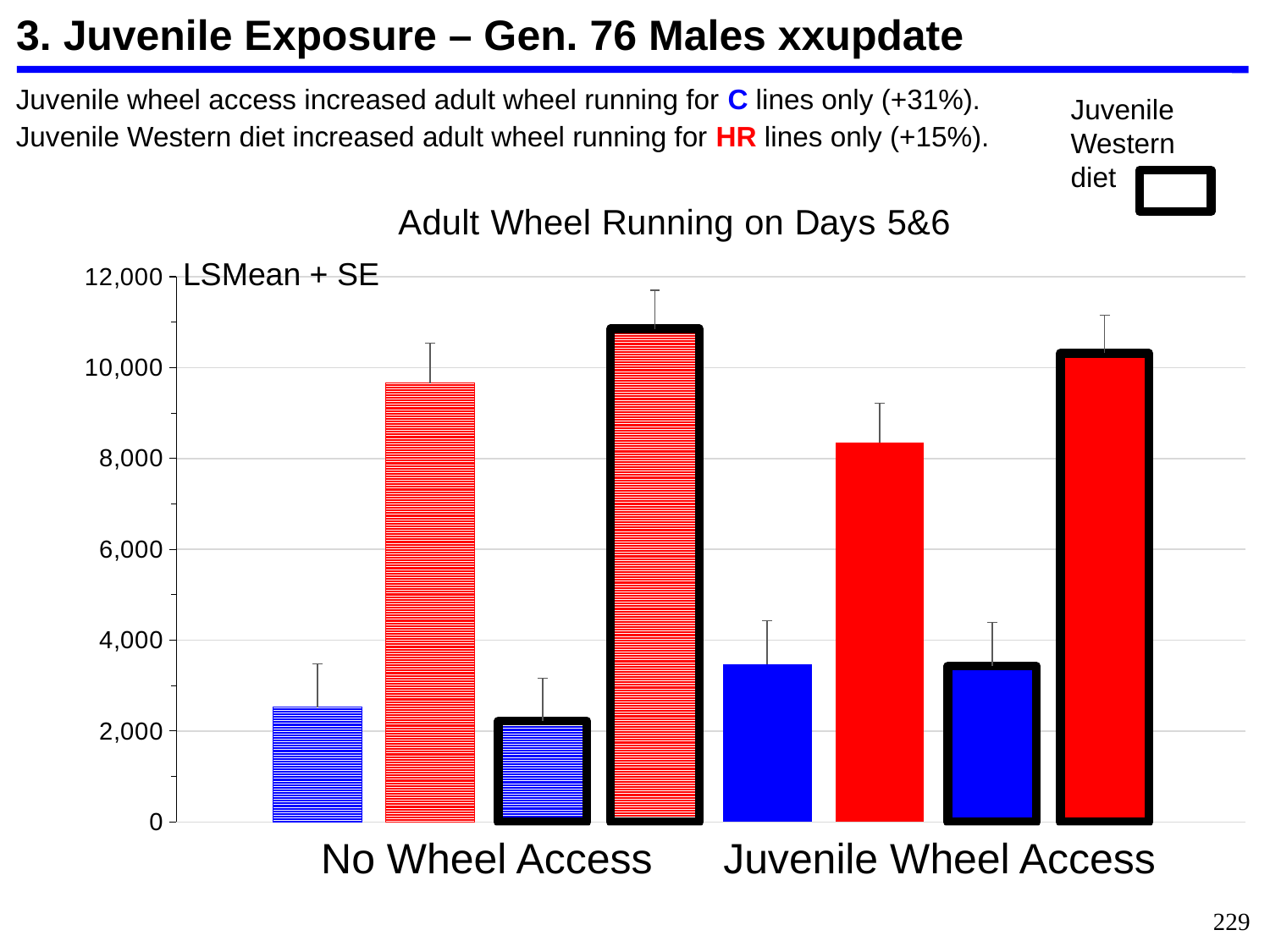
How many bars are plotted in the No Wheel Access group? 4 What is the title of the chart? Adult Wheel Running on Days 5&6 Is the value of the solid red bar in the No Wheel Access group greater or less than 8,000? greater Is the value of the blue bar with the black outline in the Juvenile Wheel Access group greater or less than 2,000? greater Which bar is the tallest in the chart? the red bar with black outline in the No Wheel Access group Is the value of the solid blue bar in the No Wheel Access group greater or less than 4,000? less What does the black outline on a bar indicate, according to the legend on the slide? Juvenile Western diet What kind of chart is shown on the slide? bar chart How many categories are shown on the x axis of the chart? 2 Which is larger: the solid red bar in the No Wheel Access group or the solid red bar in the Juvenile Wheel Access group? No Wheel Access